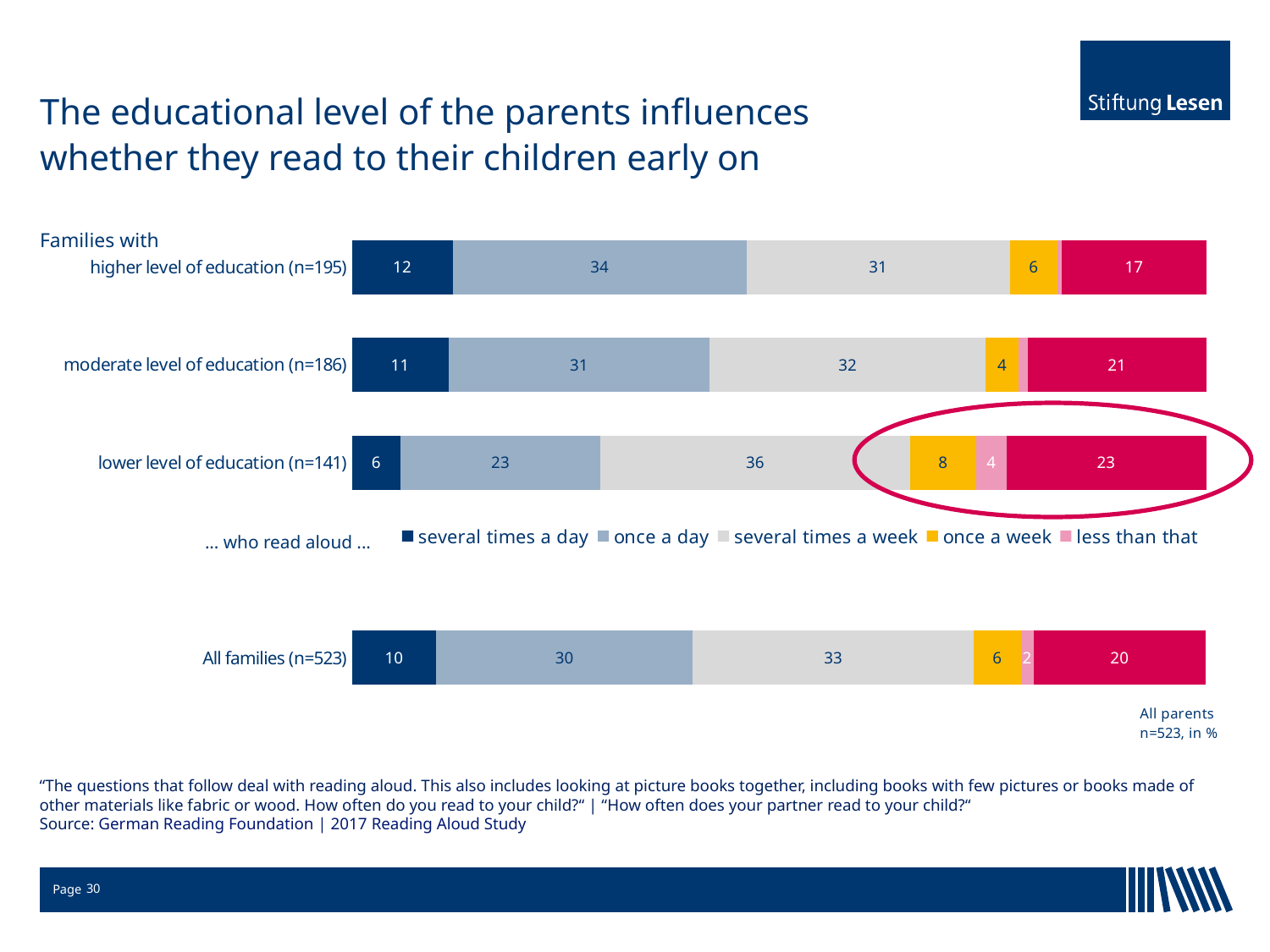
What is the value for 'less than that' for families with a lower level of education (n=141)? 4 What is the value for 'once a week' for families with a lower level of education (n=141)? 8 How many series does the legend list? 5 What type of chart is shown on the slide? stacked bar chart How many family groups (bars) are shown in the chart? 4 Which family group has the highest value for 'several times a week'? lower level of education (n=141) What is the value for 'several times a week' for families with a moderate level of education (n=186)? 32 Which family group has the lowest value for 'several times a day'? lower level of education (n=141) What percentage of families with a higher level of education (n=195) read aloud several times a day? 12 What is the difference between the 'once a day' values for families with a higher level of education and families with a lower level of education? 11 Which group has a larger 'once a week' value: families with a higher level of education or families with a moderate level of education? higher level of education (n=195) What is the value for 'once a day' for All families (n=523)? 30